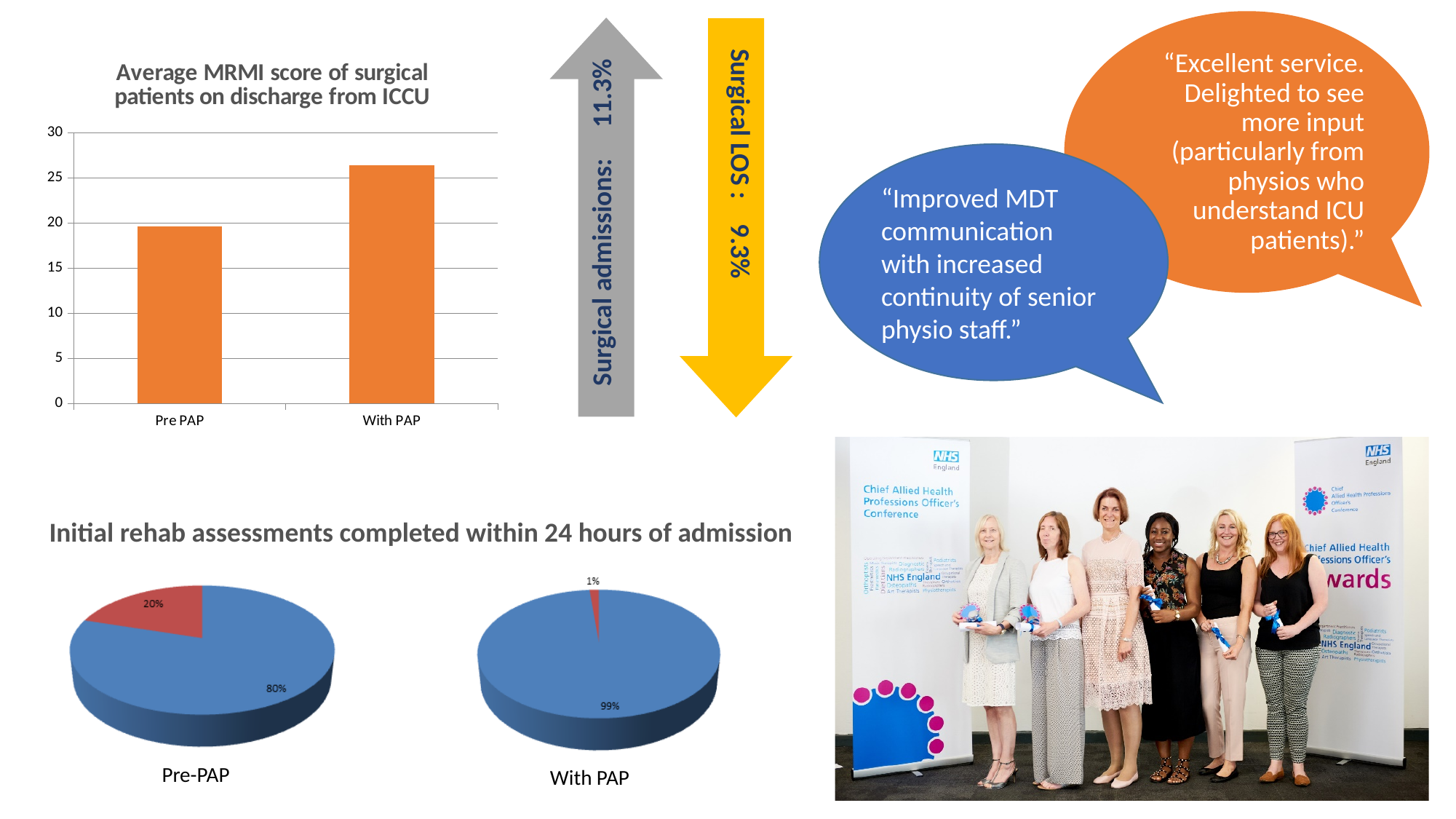
In the 'Average MRMI score of surgical patients on discharge from ICCU' bar chart, is the value for Pre PAP greater or less than 15? greater What is the difference between the two slices in the Pre-PAP pie chart under 'Initial rehab assessments completed within 24 hours of admission'? 60% In the 'Average MRMI score of surgical patients on discharge from ICCU' bar chart, what is the highest value shown on the vertical axis? 30 In the 'Average MRMI score of surgical patients on discharge from ICCU' bar chart, is the value for With PAP greater or less than 20? greater In the Pre-PAP pie chart under 'Initial rehab assessments completed within 24 hours of admission', what share does the red slice have? 20% What kind of chart is the 'Average MRMI score of surgical patients on discharge from ICCU' chart? bar chart In the With PAP pie chart under 'Initial rehab assessments completed within 24 hours of admission', what share does the larger (blue) slice have? 99% In the 'Average MRMI score of surgical patients on discharge from ICCU' bar chart, which category has the higher value, Pre PAP or With PAP? With PAP In the 'Average MRMI score of surgical patients on discharge from ICCU' bar chart, which category has the lowest value? Pre PAP What kind of chart is used for the Pre-PAP 'Initial rehab assessments completed within 24 hours of admission' chart? pie chart How many categories are shown on the x axis of the 'Average MRMI score of surgical patients on discharge from ICCU' bar chart? 2 In the Pre-PAP pie chart under 'Initial rehab assessments completed within 24 hours of admission', what share does the larger (blue) slice have? 80%